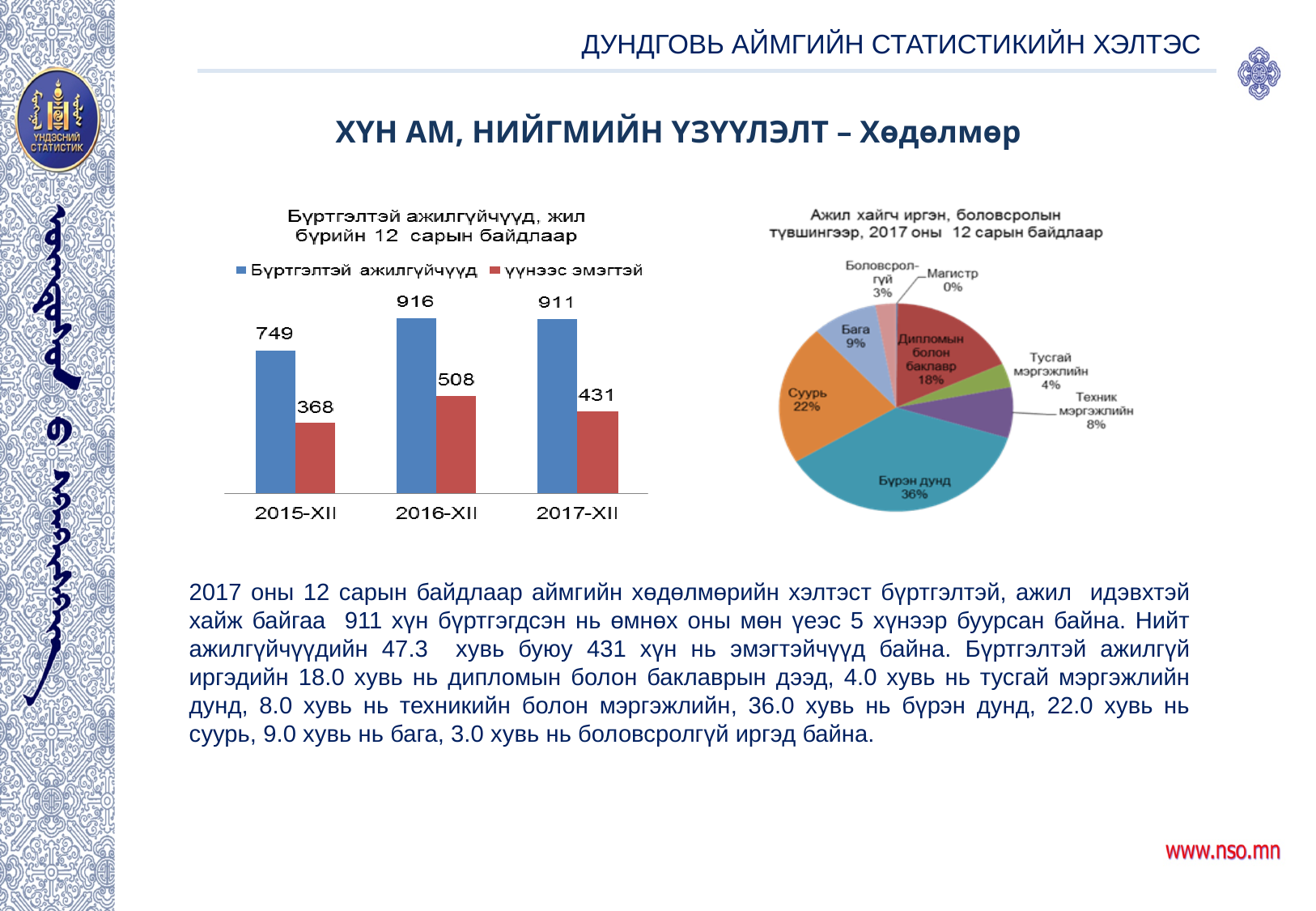
In the bar chart on the left, which period has the highest value for 'Бүртгэлтэй ажилгүйчүүд'? 2016-XII In the pie chart on the right, which category has the largest share? Бүрэн дунд In the bar chart on the left, how many series does the legend list? 2 In the pie chart on the right, which is larger: 'Бага' or 'Техник мэргэжлийн'? Бага In the bar chart on the left, how many periods are shown on the x axis? 3 In the bar chart on the left, which period has the lowest value for 'үүнээс эмэгтэй'? 2015-XII In the bar chart on the left, what is the value of 'Бүртгэлтэй ажилгүйчүүд' for 2016-XII? 916 In the bar chart on the left, what is the value of 'үүнээс эмэгтэй' for 2017-XII? 431 In the pie chart on the right, what share does 'Бүрэн дунд' have? 36% What kind of chart is the chart on the left? Bar chart In the bar chart on the left, what is the difference between the 'Бүртгэлтэй ажилгүйчүүд' values for 2016-XII and 2017-XII? 5 In the pie chart on the right, what share does 'Суурь' have? 22%